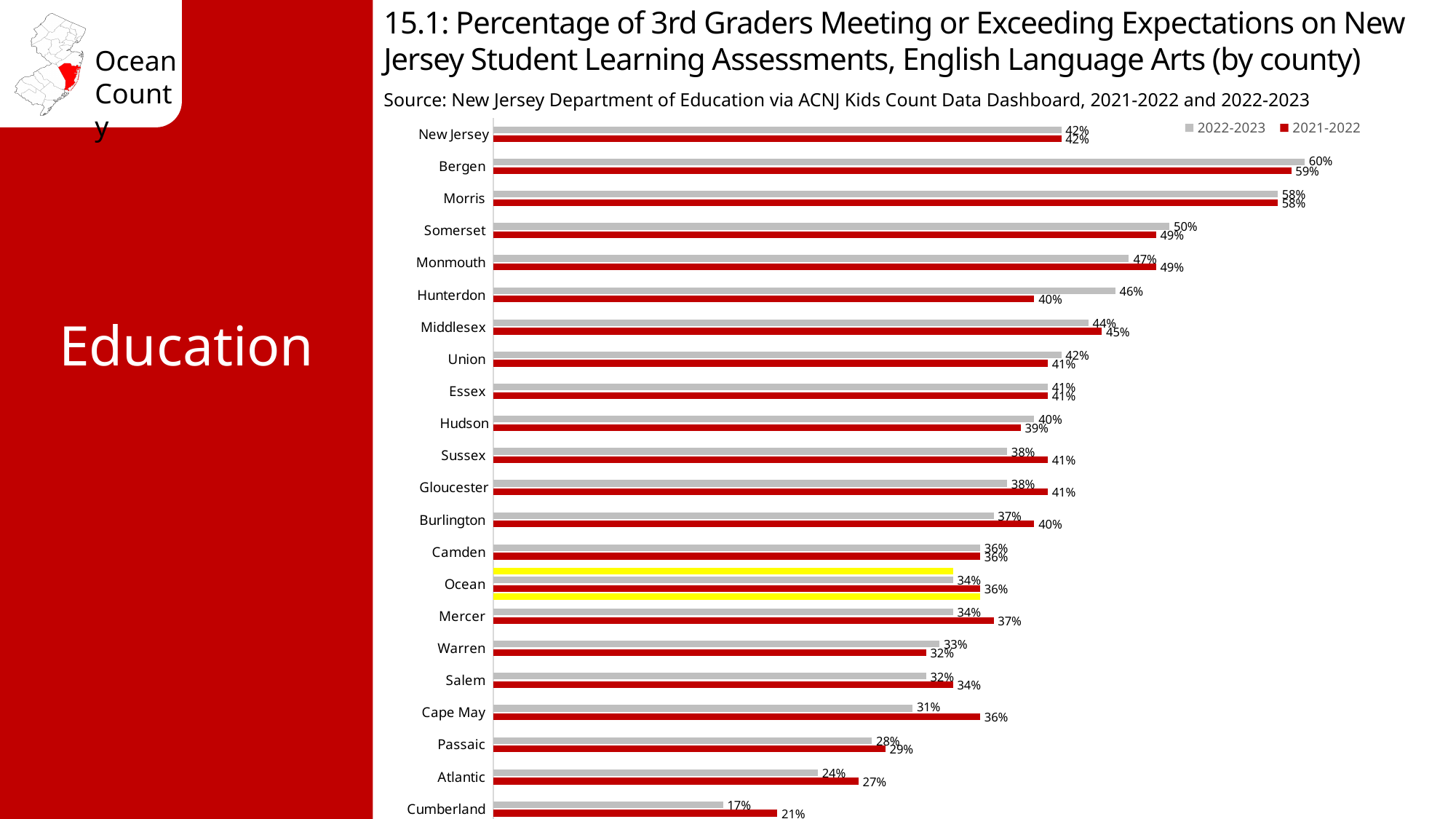
Which county had the highest percentage in 2022-2023? Bergen How many counties (excluding the New Jersey statewide bar) are shown on the chart? 21 Which county had the lowest percentage in 2021-2022? Cumberland What type of chart is shown on the slide? Bar chart What percentage of 3rd graders in Ocean County met or exceeded expectations in 2022-2023? 34% How many series does the legend list? 2 Which county's bars are highlighted in yellow on the chart? Ocean What was the 2021-2022 value for Hunterdon? 40% Which was higher for Ocean County: the 2021-2022 value or the 2022-2023 value? 2021-2022 By how many percentage points did Hunterdon's value change from 2021-2022 to 2022-2023? 6 percentage points What was the 2022-2023 value for Cape May? 31% What is the difference between Bergen's and Cumberland's 2022-2023 values? 43 percentage points